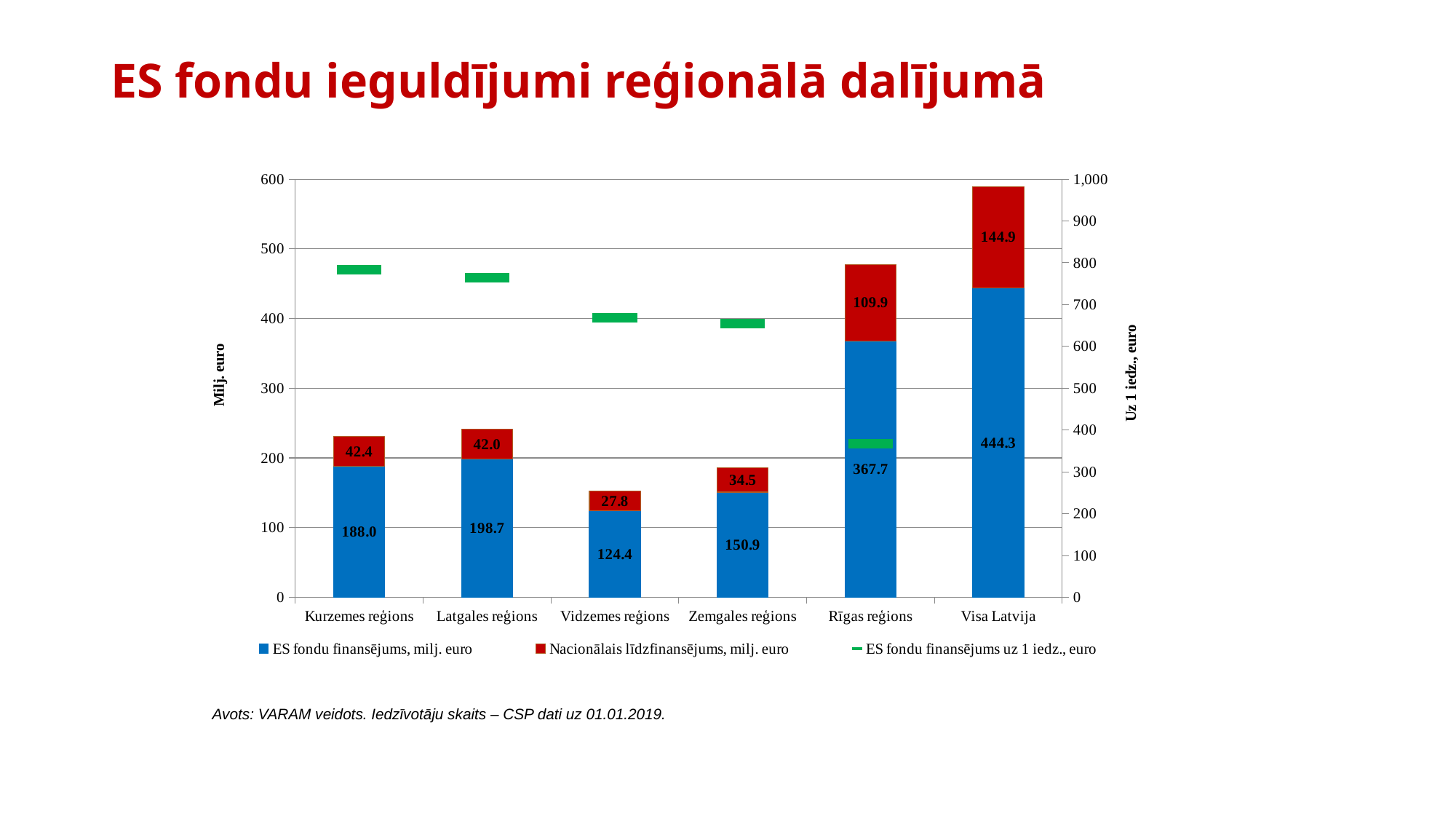
What is the value of ES fondu finansējums, milj. euro for Visa Latvija? 444.3 What is the value of ES fondu finansējums, milj. euro for Rīgas reģions? 367.7 Which region (excluding Visa Latvija) has the lowest ES fondu finansējums, milj. euro? Vidzemes reģions Is the value of ES fondu finansējums uz 1 iedz., euro for Rīgas reģions greater or less than 400? less What is the value of Nacionālais līdzfinansējums, milj. euro for Vidzemes reģions? 27.8 Which has a larger ES fondu finansējums, milj. euro: Kurzemes reģions or Latgales reģions? Latgales reģions Which category has the highest Nacionālais līdzfinansējums, milj. euro? Visa Latvija What is the total of the stacked bar for Kurzemes reģions (ES fondu finansējums plus Nacionālais līdzfinansējums), in milj. euro? 230.4 What is the difference in ES fondu finansējums, milj. euro between Rīgas reģions and Zemgales reģions? 216.8 Is the value of ES fondu finansējums uz 1 iedz., euro for Kurzemes reģions greater or less than 700? greater How many categories are shown on the x axis? 6 How many series does the legend list? 3